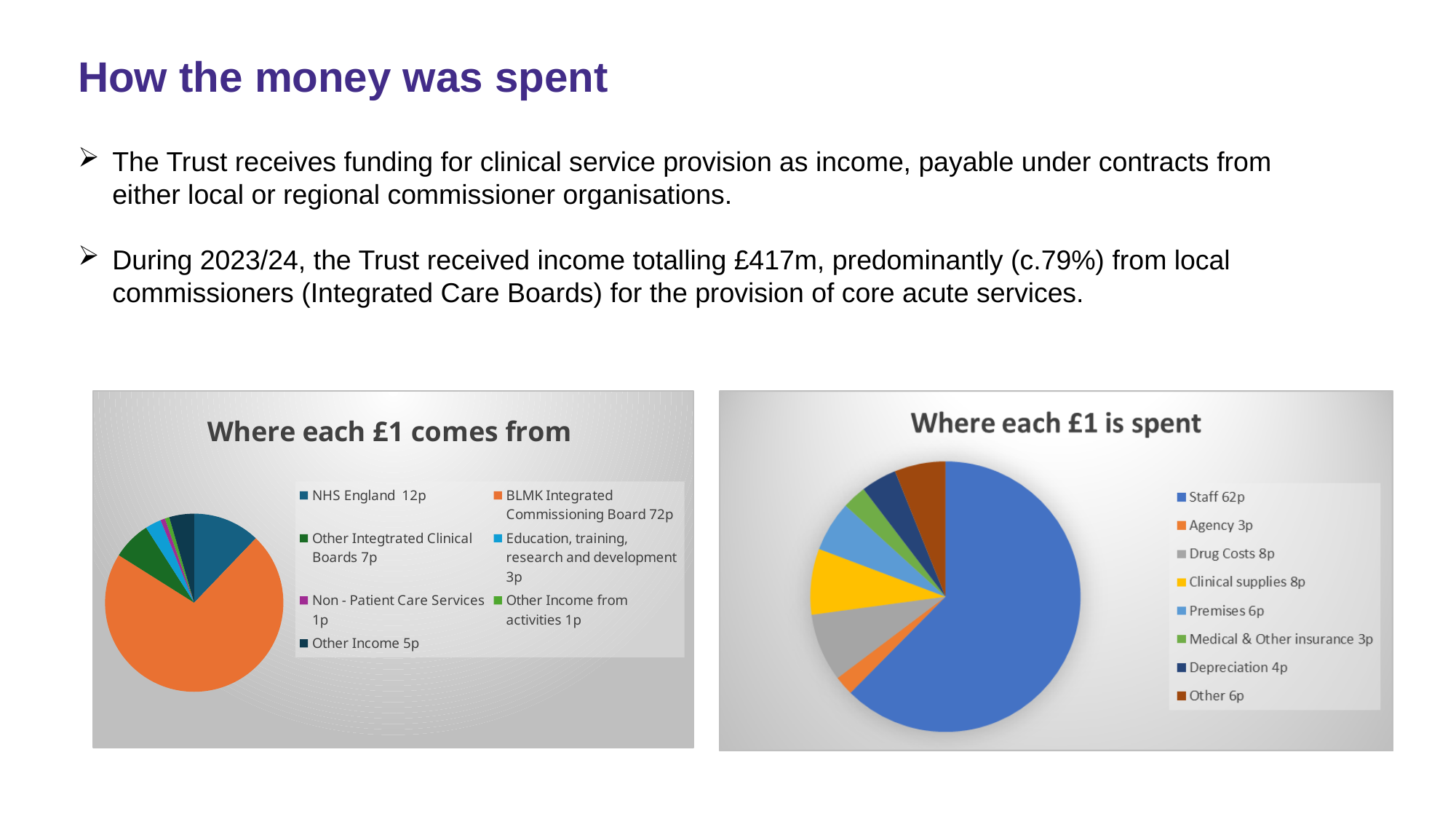
How many categories does the 'Where each £1 is spent' chart show? 8 In the 'Where each £1 is spent' chart, how much of each £1 goes to Staff? 62p In the 'Where each £1 is spent' chart, which is larger, Premises or Depreciation? Premises In the 'Where each £1 is spent' chart, which category is the largest? Staff In the 'Where each £1 comes from' chart, how much of each £1 comes from the BLMK Integrated Commissioning Board? 72p In the 'Where each £1 is spent' chart, what is the difference between Staff and Drug Costs? 54p How many categories does the 'Where each £1 comes from' chart show? 7 In the 'Where each £1 is spent' chart, what is the difference between Clinical supplies and Agency? 5p In the 'Where each £1 comes from' chart, which source is the largest? BLMK Integrated Commissioning Board What type of chart is 'Where each £1 is spent'? Pie chart In the 'Where each £1 comes from' chart, which is larger, NHS England or Other Integrated Clinical Boards? NHS England In the 'Where each £1 comes from' chart, how much comes from NHS England? 12p